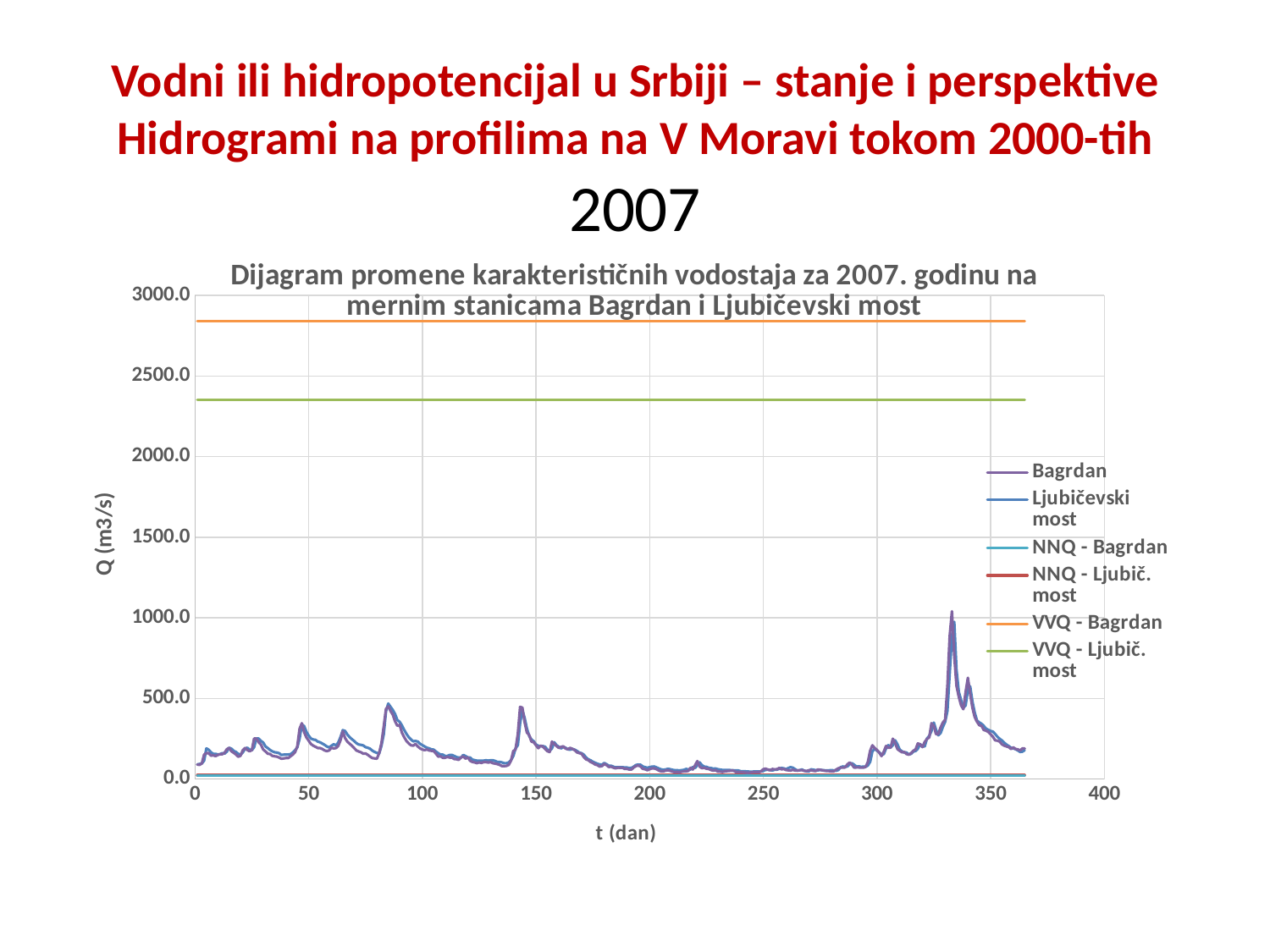
What kind of chart is shown on the slide? line chart Is the value of the VVQ - Bagrdan line greater or less than 2500? greater What is the label of the horizontal axis of the chart? t (dan) How many series does the chart legend list? 6 Is the highest peak of the Bagrdan series greater or less than 500? greater Is the value of the VVQ - Ljubič. most line greater or less than 2500? less Which is larger, the VVQ - Bagrdan line or the VVQ - Ljubič. most line? VVQ - Bagrdan What is the label of the vertical axis of the chart? Q (m3/s) Which series has the highest values on the chart? VVQ - Bagrdan